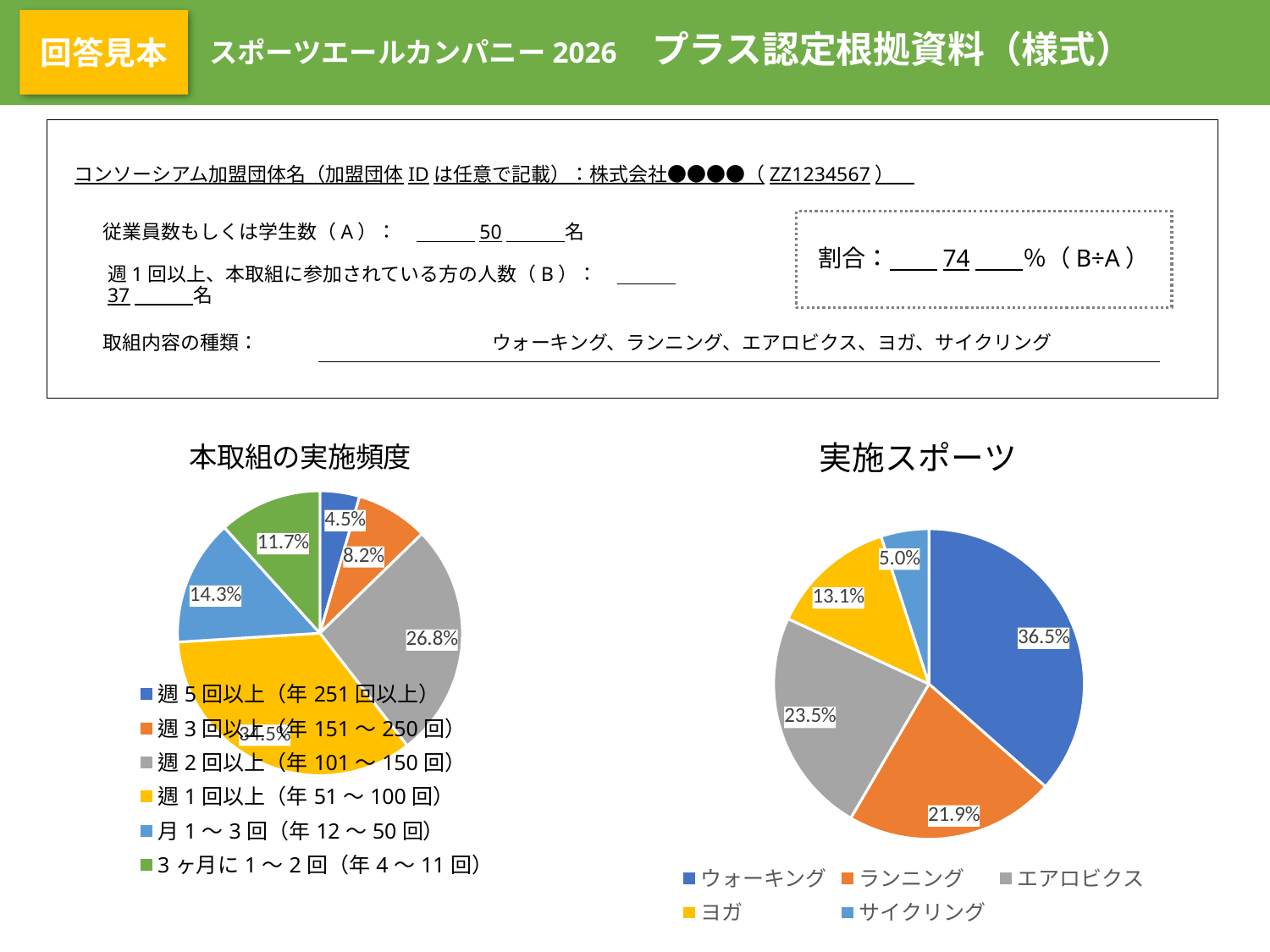
In the 本取組の実施頻度 pie chart, which is larger, 月1〜3回（年12〜50回） or 3ヶ月に1〜2回（年4〜11回）? 月1〜3回（年12〜50回） In the 実施スポーツ pie chart, which sport has the smallest share? サイクリング In the 実施スポーツ pie chart, which is larger, エアロビクス or ランニング? エアロビクス How many categories does the legend of the 実施スポーツ pie chart list? 5 In the 実施スポーツ pie chart, what share does サイクリング have? 5.0% In the 本取組の実施頻度 pie chart, what share does 週5回以上（年251回以上） have? 4.5% In the 実施スポーツ pie chart, which sport has the largest share? ウォーキング In the 本取組の実施頻度 pie chart, what share does 週2回以上（年101〜150回） have? 26.8% In the 本取組の実施頻度 pie chart, which category has the smallest share? 週5回以上（年251回以上） In the 実施スポーツ pie chart, what is the difference between the shares of ウォーキング and ヨガ? 23.4% In the 実施スポーツ pie chart, what share does ウォーキング have? 36.5% What type of chart is the 本取組の実施頻度 chart? Pie chart